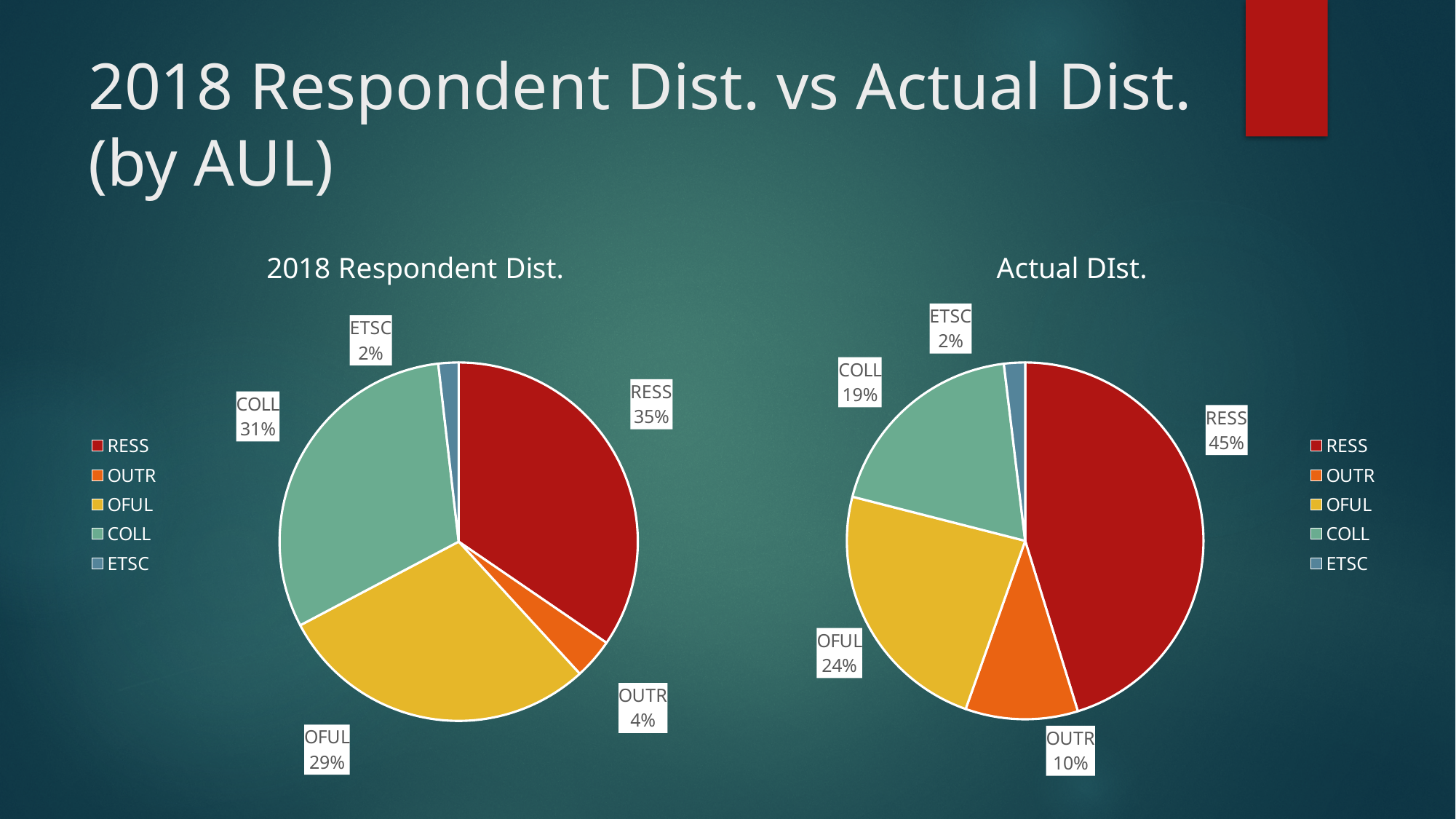
What is the difference between the RESS share in the 'Actual DIst.' chart and the RESS share in the '2018 Respondent Dist.' chart? 10% How many categories does the '2018 Respondent Dist.' pie chart show? 5 What type of chart is the 'Actual DIst.' chart? Pie chart In the 'Actual DIst.' chart, what share does OFUL have? 24% Is the OUTR share larger in the '2018 Respondent Dist.' chart or in the 'Actual DIst.' chart? Actual DIst. In the 'Actual DIst.' chart, which category has the smallest slice? ETSC In the 'Actual DIst.' chart, which is larger, the COLL slice or the OFUL slice? OFUL In the '2018 Respondent Dist.' chart, what share does RESS have? 35% In the 'Actual DIst.' chart, what share does OUTR have? 10% In the '2018 Respondent Dist.' chart, what is the difference between the COLL and OFUL shares? 2% In the 'Actual DIst.' chart, what colour is the COLL slice? Green In the '2018 Respondent Dist.' chart, which category has the largest slice? RESS